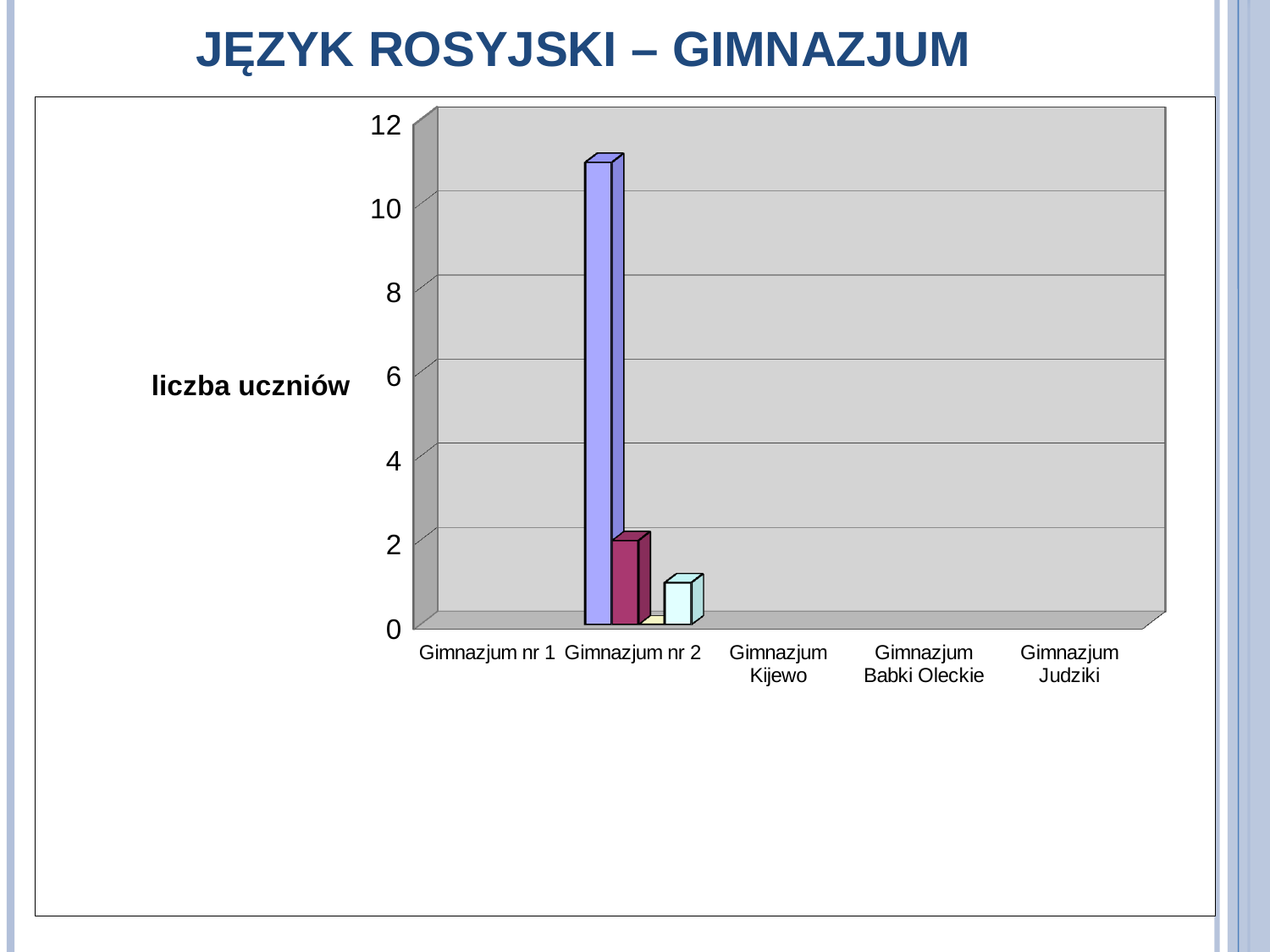
How many bars are visibly plotted in the chart? 4 Is the value of the tallest (blue) bar greater or less than 10? greater Is the value of the light blue bar greater or less than 2? less What is the label on the vertical axis of the chart? liczba uczniów What is the highest value shown on the vertical axis of the chart? 12 What is the title of the slide containing the chart? JĘZYK ROSYJSKI – GIMNAZJUM What kind of chart is shown on the slide? bar chart Is the value of the red bar greater or less than 4? less How many category labels are shown along the x axis of the chart? 5 Which bar is taller, the blue bar or the red bar? the blue bar Which bar is taller, the red bar or the light blue bar? the red bar